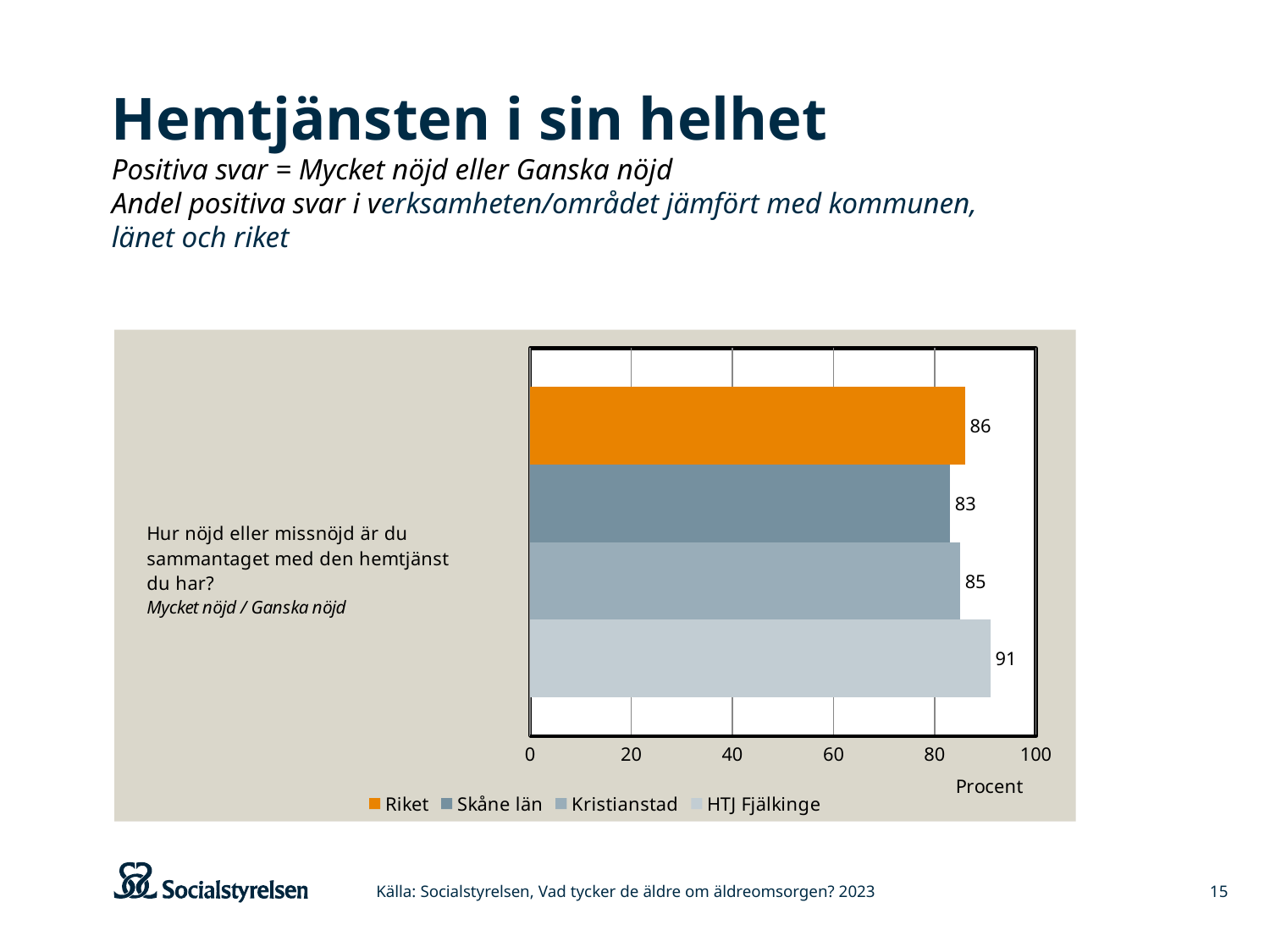
What is the value for Riket? 86 Which is larger, the value for HTJ Fjälkinge or the value for Kristianstad? HTJ Fjälkinge What is the value for HTJ Fjälkinge? 91 How many series does the legend list? 4 Which series has the highest value? HTJ Fjälkinge What is the label on the horizontal axis of the chart? Procent What is the difference between the values for HTJ Fjälkinge and Riket? 5 What is the value for Skåne län? 83 What is the value for Kristianstad? 85 Which series has the lowest value? Skåne län What is the difference between the values for Kristianstad and Skåne län? 2 What kind of chart is shown on the slide? Bar chart